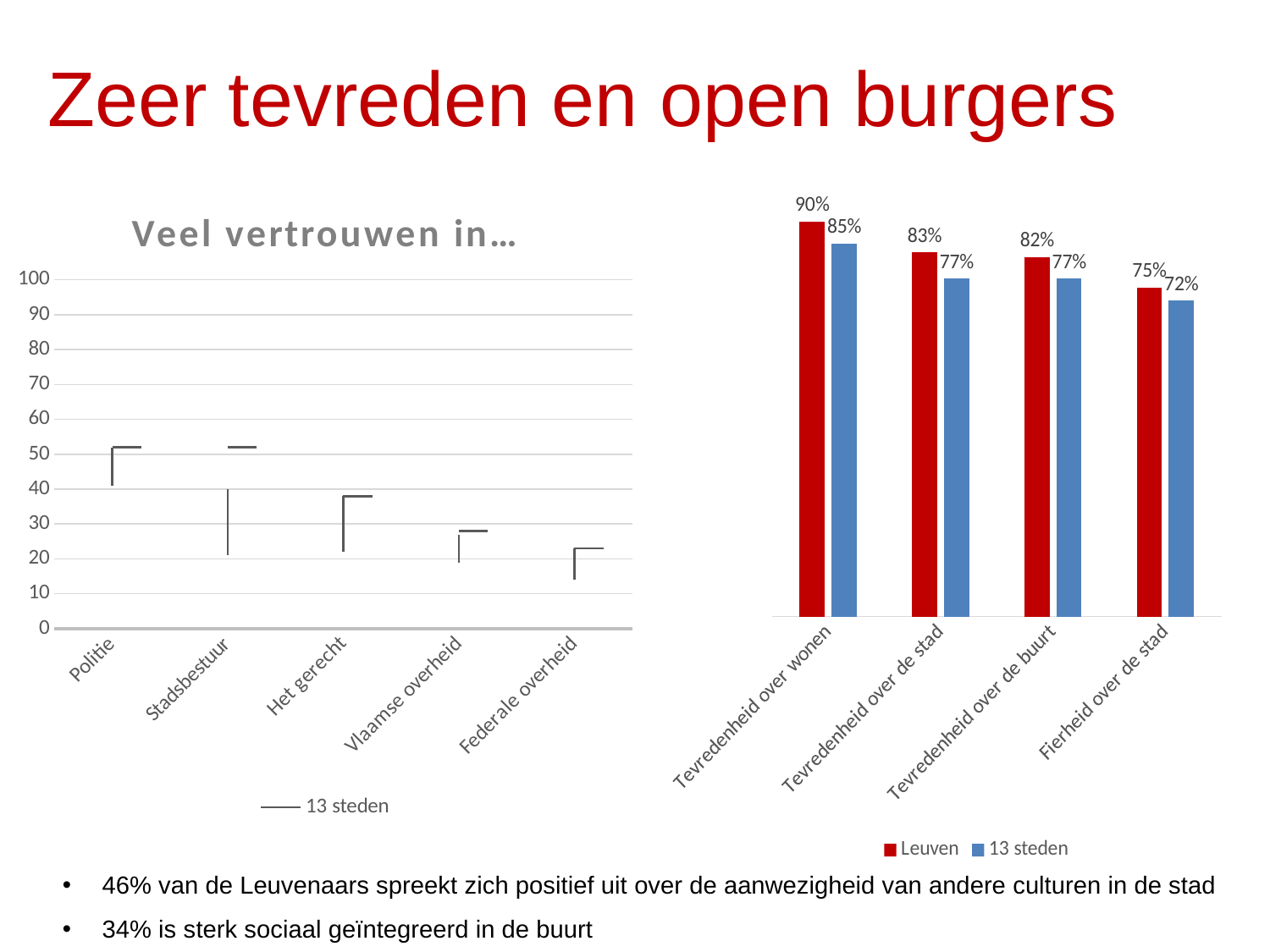
In the right-hand chart, which category has the highest value for Leuven? Tevredenheid over wonen In the right-hand chart, what is the value for Leuven for 'Tevredenheid over wonen'? 90% In the right-hand chart, do the Leuven values rise or fall from left to right across the categories? fall In the right-hand chart, what is the value for 13 steden for 'Fierheid over de stad'? 72% In the right-hand chart, which is larger for 'Tevredenheid over de buurt': Leuven or 13 steden? Leuven How many categories are shown on the x axis of the 'Veel vertrouwen in…' chart? 5 How many series does the legend of the right-hand chart list? 2 In the right-hand chart, which category has the lowest value for Leuven? Fierheid over de stad In the right-hand chart, what is the value for 13 steden for 'Tevredenheid over de buurt'? 77% In the 'Veel vertrouwen in…' chart, is the value for 'Federale overheid' greater or less than 30? less What kind of chart is the right-hand chart? bar chart In the right-hand chart, what is the difference between Leuven and 13 steden for 'Tevredenheid over de stad'? 6 percentage points